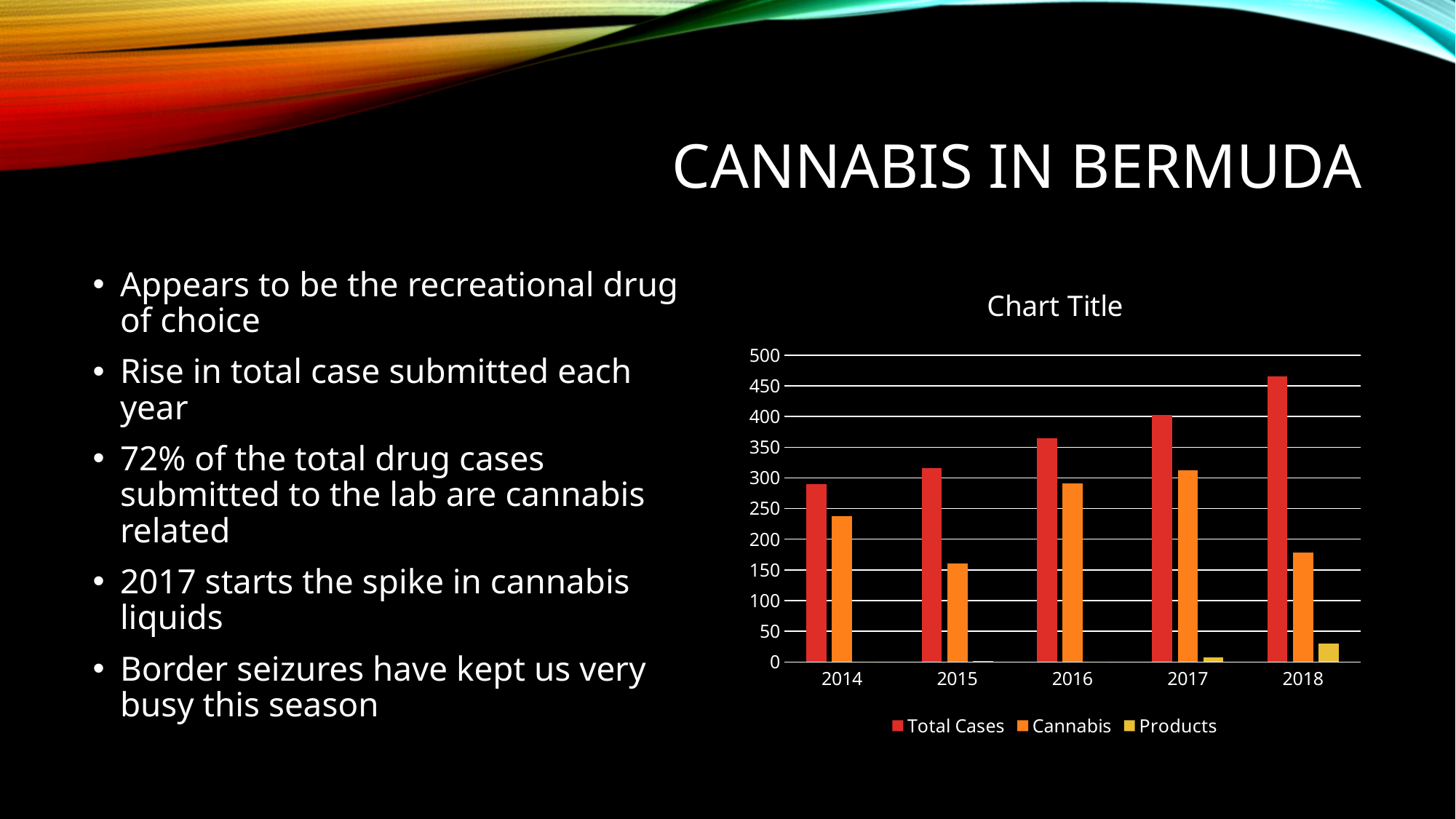
What are the three series named in the chart's legend? Total Cases, Cannabis, Products How many series does the chart's legend list? 3 What kind of chart is shown on the slide? Bar chart Which year has the lowest value for Cannabis? 2015 Which is larger, the Cannabis value for 2016 or for 2018? 2016 Do the Total Cases values rise or fall from 2014 to 2018? Rise Which year has the highest value for Cannabis? 2017 How many years are shown on the x axis of the chart? 5 Which year has the highest value for Total Cases? 2018 Is the value for Products in 2018 greater or less than 50? less Is the value for Total Cases in 2014 greater or less than 300? less Is the value for Total Cases in 2018 greater or less than 450? greater